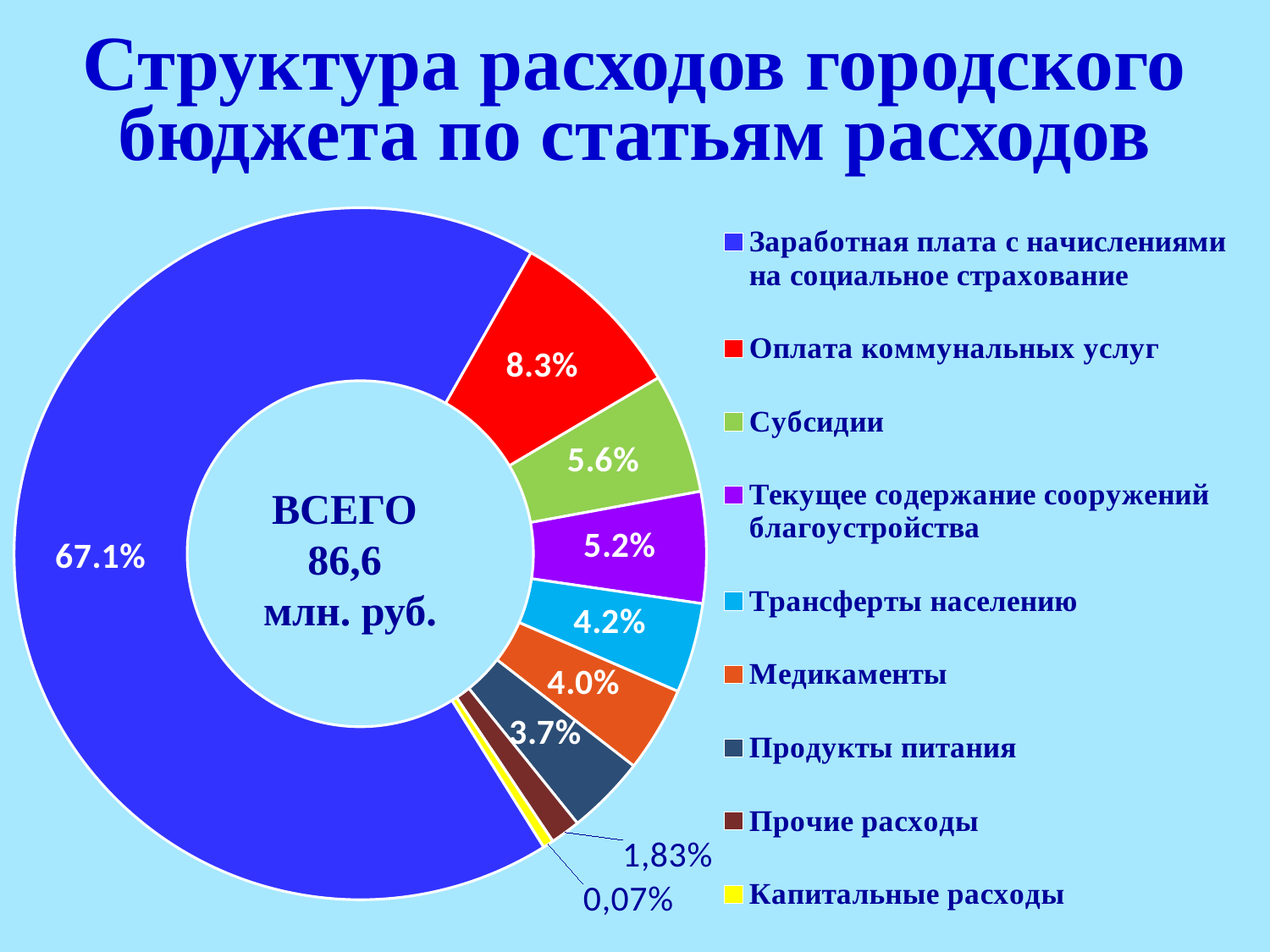
Which expenditure item has the smallest share of the budget? Капитальные расходы How many expenditure items are shown in the chart? 9 What total amount is shown in the centre of the chart? 86,6 млн. руб. Which has a larger share: Трансферты населению or Медикаменты? Трансферты населению What percentage is shown for Прочие расходы? 1,83% What percentage is shown for Капитальные расходы? 0,07% Which expenditure item has the largest share of the budget? Заработная плата с начислениями на социальное страхование What percentage is shown for Субсидии? 5.6% What percentage is shown for Оплата коммунальных услуг? 8.3% What share of the city budget expenditure goes to Заработная плата с начислениями на социальное страхование? 67.1% What type of chart is shown on the slide? Doughnut chart What is the difference in percentage points between Оплата коммунальных услуг and Субсидии? 2.7%